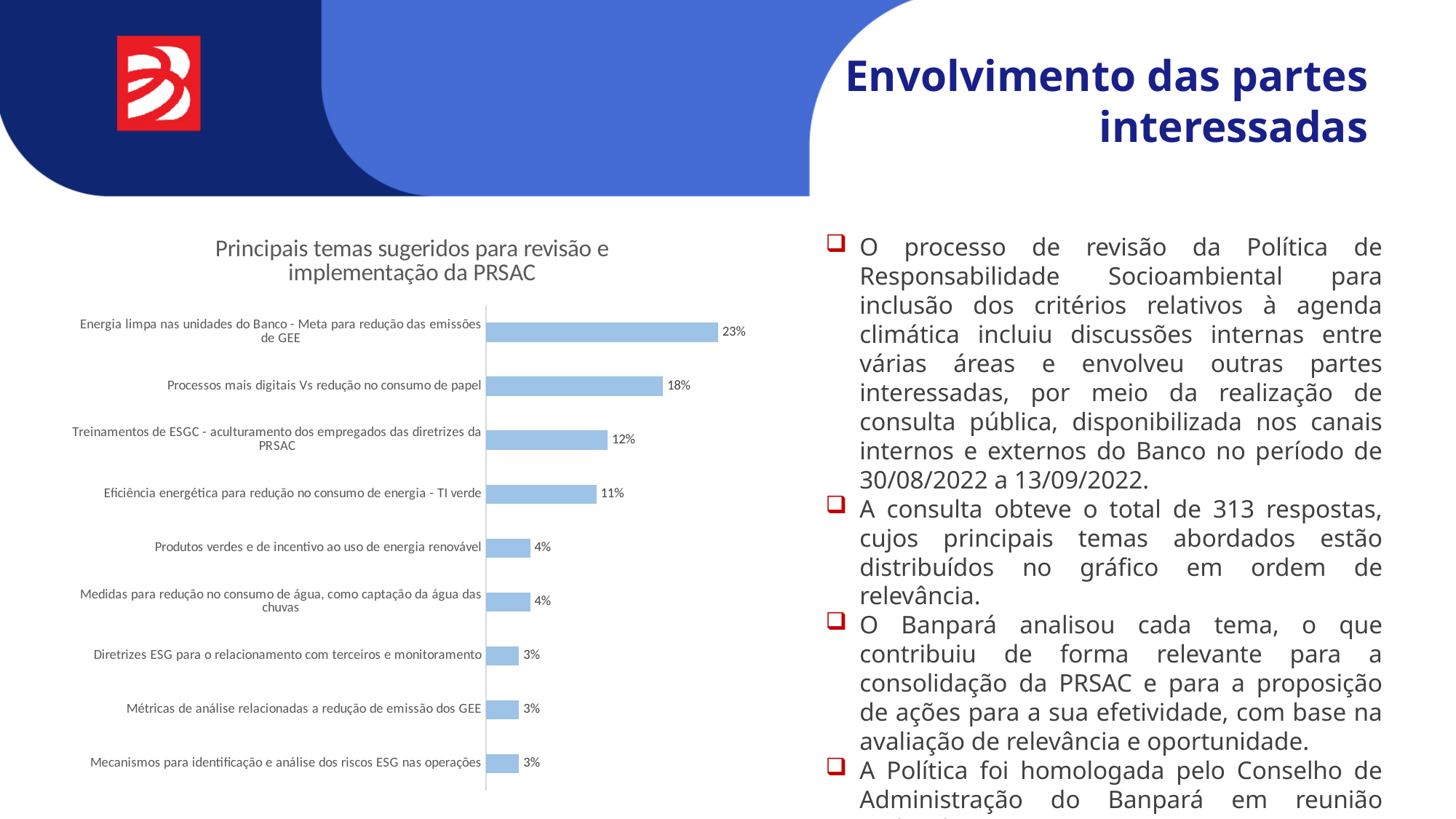
What is the value for "Produtos verdes e de incentivo ao uso de energia renovável"? 4% What is the title of the chart? Principais temas sugeridos para revisão e implementação da PRSAC How many categories are plotted in the chart? 9 What is the value for "Processos mais digitais Vs redução no consumo de papel"? 18% What is the difference between the values for "Eficiência energética para redução no consumo de energia - TI verde" and "Mecanismos para identificação e análise dos riscos ESG nas operações"? 8% What is the difference between the values for "Energia limpa nas unidades do Banco - Meta para redução das emissões de GEE" and "Processos mais digitais Vs redução no consumo de papel"? 5% Which is larger: the value for "Treinamentos de ESGC - aculturamento dos empregados das diretrizes da PRSAC" or the value for "Produtos verdes e de incentivo ao uso de energia renovável"? Treinamentos de ESGC - aculturamento dos empregados das diretrizes da PRSAC What is the value for "Diretrizes ESG para o relacionamento com terceiros e monitoramento"? 3% What is the value for "Treinamentos de ESGC - aculturamento dos empregados das diretrizes da PRSAC"? 12% Which category has the highest value? Energia limpa nas unidades do Banco - Meta para redução das emissões de GEE What type of chart is shown on the slide? bar chart What is the value for "Eficiência energética para redução no consumo de energia - TI verde"? 11%